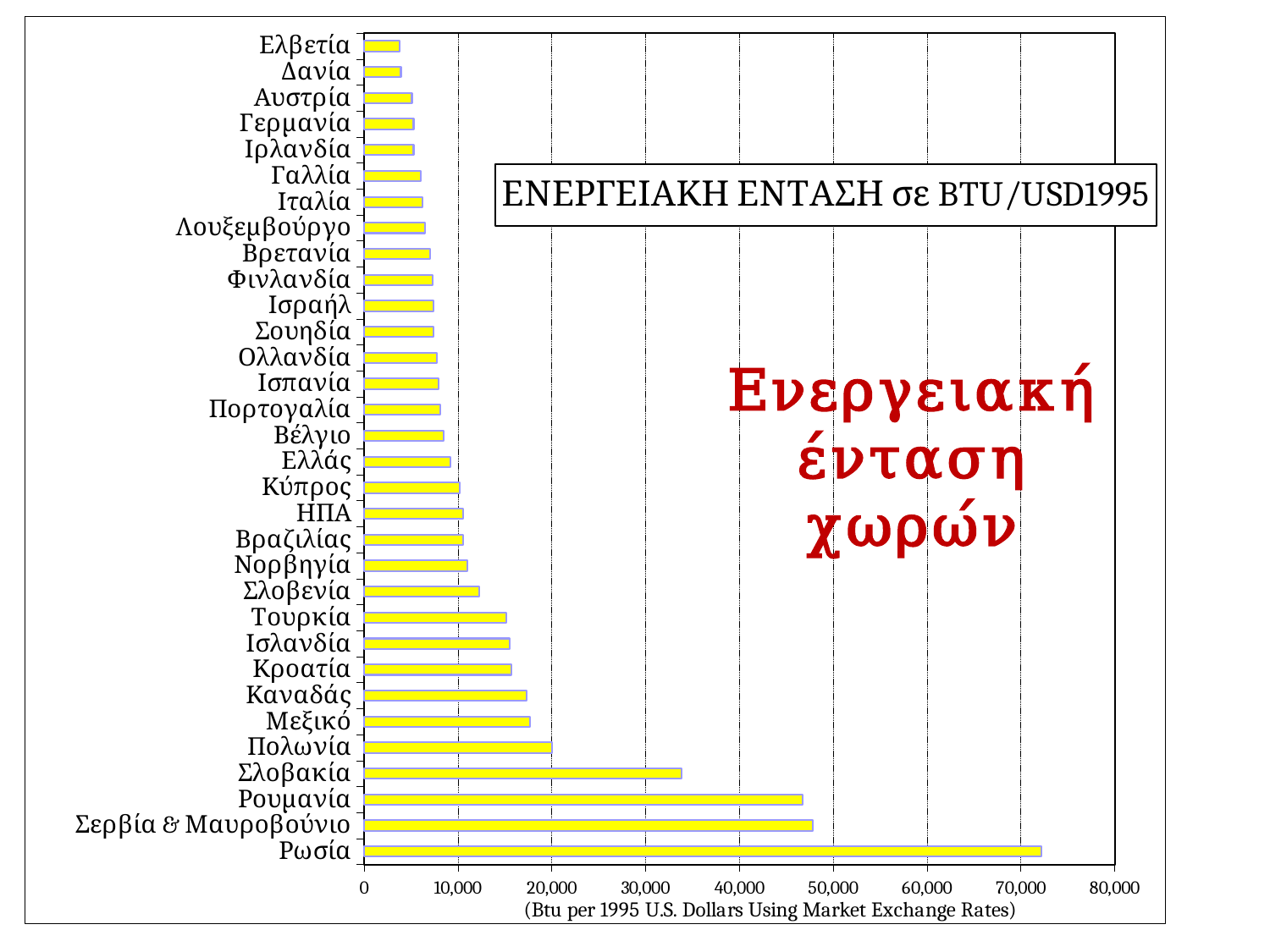
What is the title shown in the box on the chart? ΕΝΕΡΓΕΙΑΚΗ ΕΝΤΑΣΗ σε BTU/USD1995 Is the value for Ρωσία greater or less than 70,000? greater How many countries are listed in the chart? 32 What is the highest value shown on the horizontal axis? 80,000 Which has the larger value, Ρωσία or Σλοβακία? Ρωσία Is the value for Ελλάς greater or less than 10,000? less Is the value for Σλοβακία greater or less than 30,000? greater What kind of chart is shown on the slide? bar chart Which country has the highest energy intensity in the chart? Ρωσία Which has the larger value, Πολωνία or Ελλάς? Πολωνία